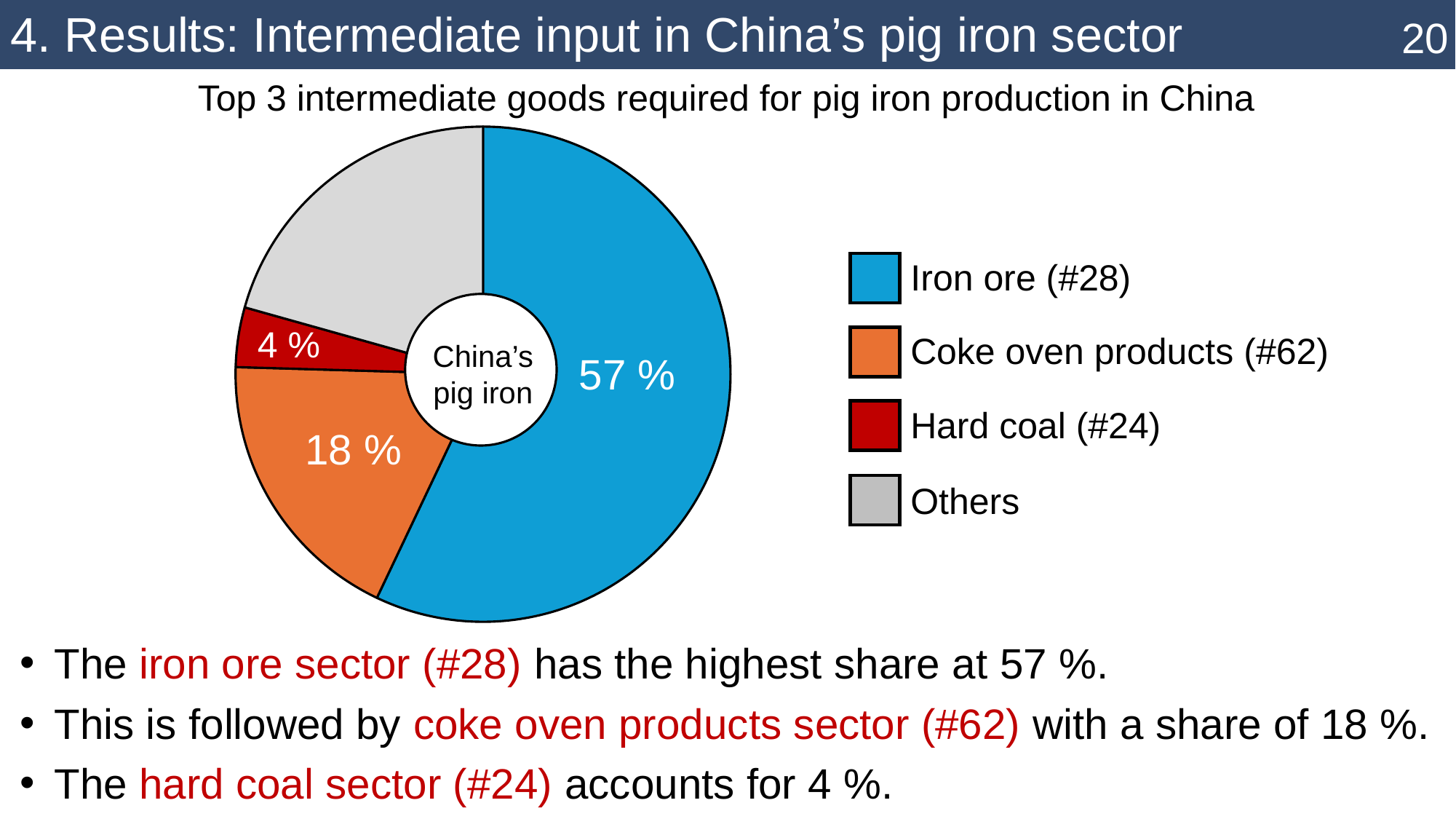
How many entries does the legend list? 4 What is the title of the chart? Top 3 intermediate goods required for pig iron production in China What share of the pie chart does Hard coal (#24) account for? 4 % What is the difference between the Coke oven products (#62) share and the Hard coal (#24) share? 14 % Which slice is larger: Others or Hard coal (#24)? Others How many slices does the pie chart have? 4 How many percentage points larger is the Iron ore (#28) share than the Coke oven products (#62) share? 39 % What type of chart is shown on the slide? Pie chart Which category has the largest slice in the pie chart? Iron ore (#28) What share of the pie chart does Coke oven products (#62) account for? 18 % What share of the pie chart does Iron ore (#28) account for? 57 % Which category has the smallest slice in the pie chart? Hard coal (#24)